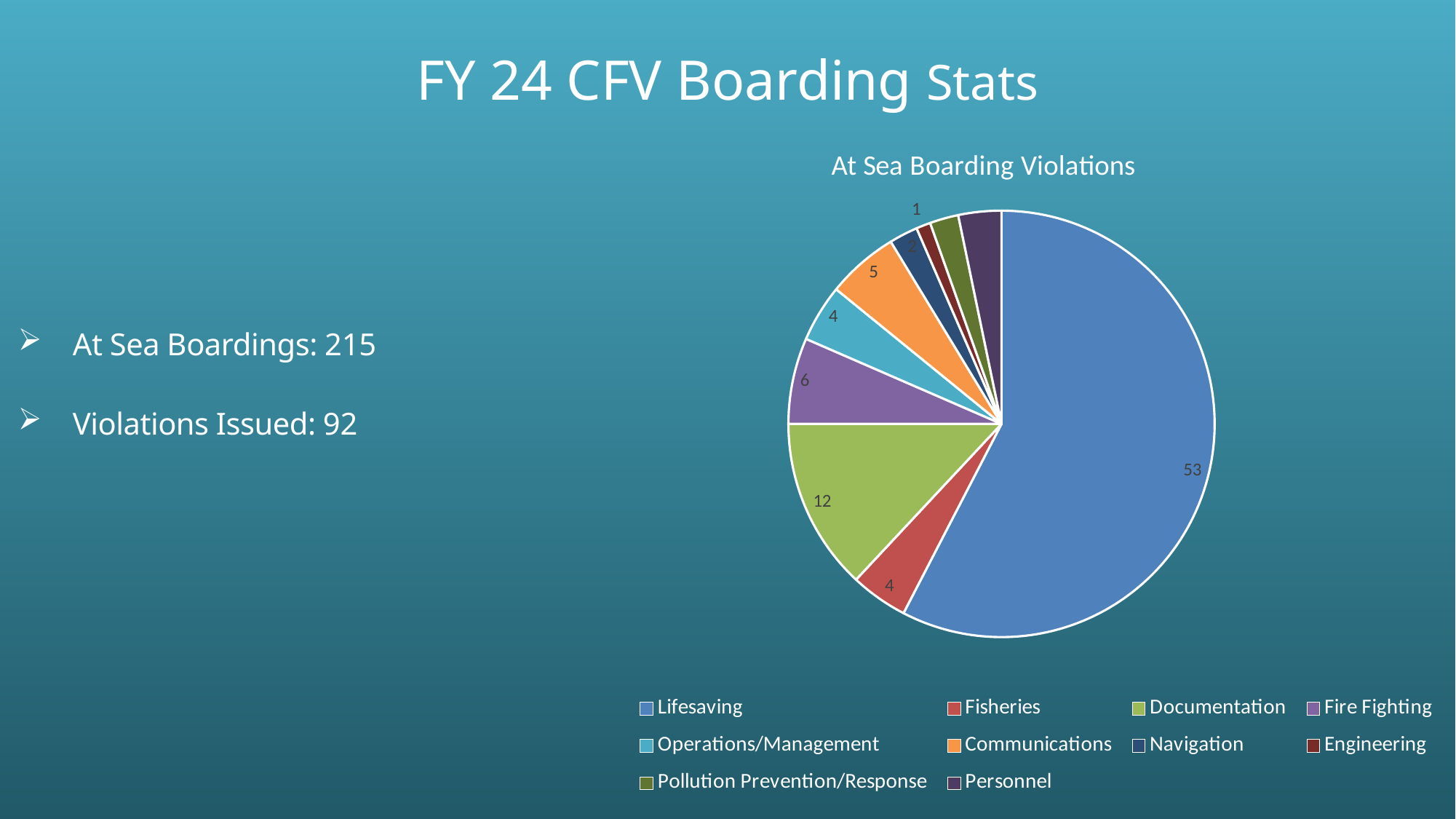
What is the value for Communications in the At Sea Boarding Violations pie chart? 5 In the At Sea Boarding Violations pie chart, which is larger: Fire Fighting or Communications? Fire Fighting What is the difference between the Lifesaving and Documentation values in the At Sea Boarding Violations pie chart? 41 What is the value for Documentation in the At Sea Boarding Violations pie chart? 12 Which category has the largest slice in the At Sea Boarding Violations pie chart? Lifesaving What is the value for Navigation in the At Sea Boarding Violations pie chart? 2 Which category has the smallest slice in the At Sea Boarding Violations pie chart? Engineering What is the value for Lifesaving in the At Sea Boarding Violations pie chart? 53 What kind of chart is shown on the slide? Pie chart What is the value for Fire Fighting in the At Sea Boarding Violations pie chart? 6 What is the title of the chart on the slide? At Sea Boarding Violations How many categories does the legend of the At Sea Boarding Violations chart list? 10